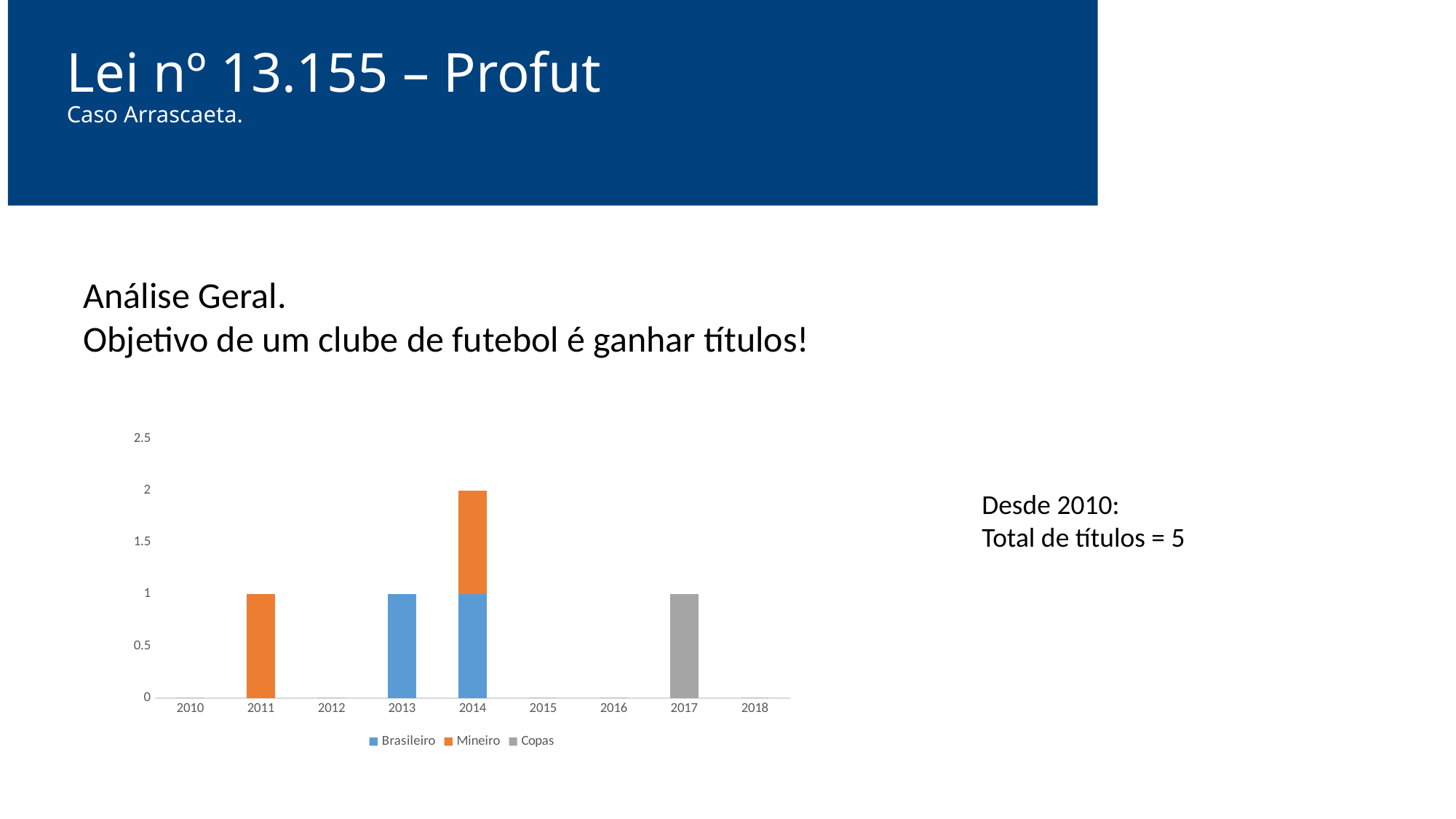
Which series has a bar in 2017? Copas What is the value for Mineiro in 2011? 1 How many series does the chart legend list? 3 How many years are shown on the x axis of the chart? 9 What is the difference between the stacked total for 2014 and the value for 2011? 1 What kind of chart is shown on the slide? bar chart What is the value for Copas in 2017? 1 Which year has the tallest stacked bar in the chart? 2014 What is the total height of the stacked bar for 2014? 2 What is the value for Brasileiro in 2013? 1 Which colour represents the Mineiro series in the chart? orange Is the total for 2014 larger than the total for 2013? Yes